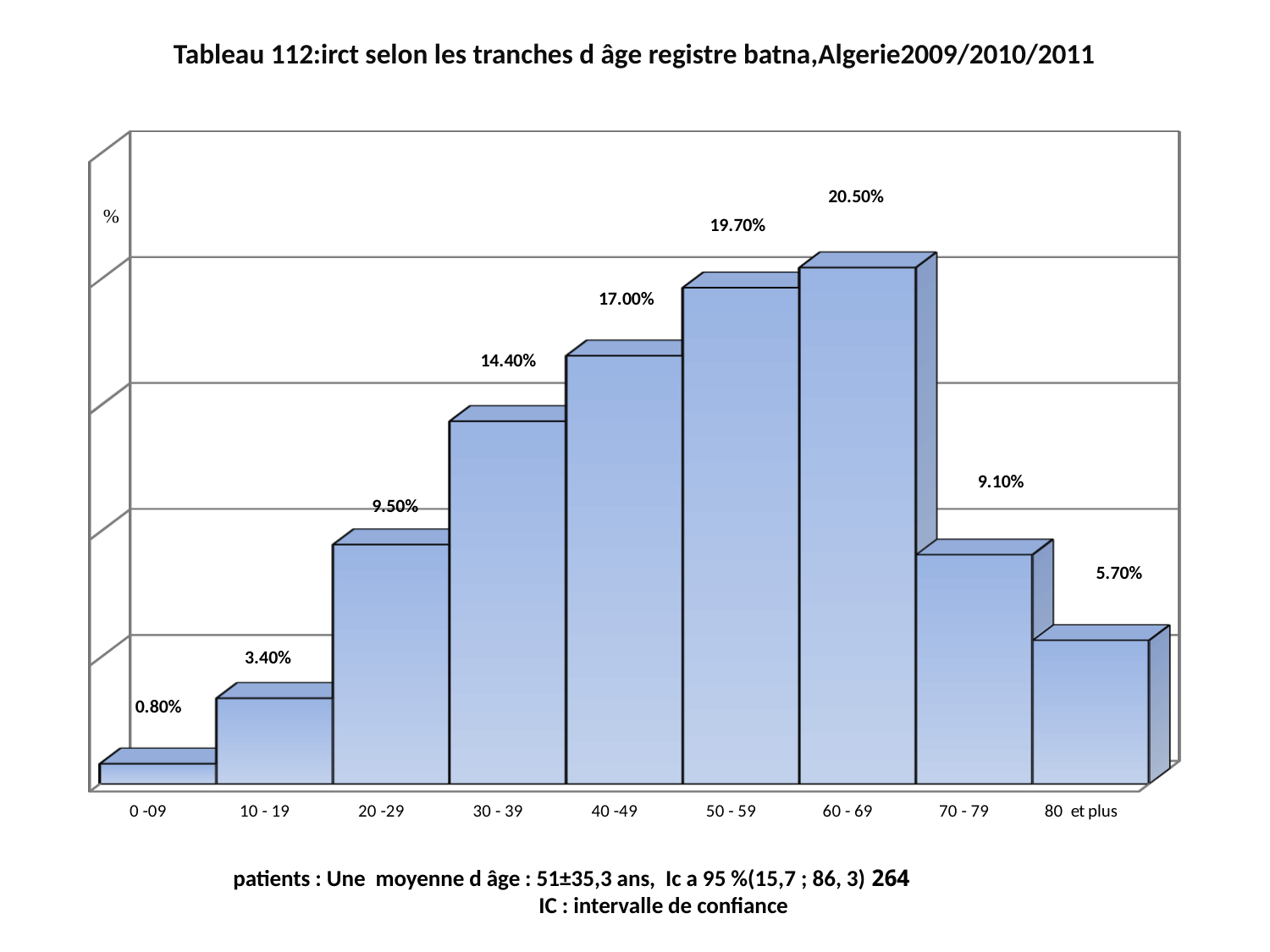
What is the value for the 80 et plus age group? 5.70% Which age group has the highest value? 60 - 69 What is the difference between the values for 70 - 79 and 80 et plus? 3.40% What is the value for the 60 - 69 age group? 20.50% What kind of chart is shown on the slide? bar chart What is the value for the 30 - 39 age group? 14.40% Which age group has the lowest value? 0 -09 Do the values rise or fall from the 0 -09 group to the 60 - 69 group? rise How many age groups are shown on the x axis? 9 Which is larger, the value for 20 -29 or the value for 70 - 79? 20 -29 What is the difference between the values for 50 - 59 and 40 -49? 2.70% What is the value for the 0 -09 age group? 0.80%